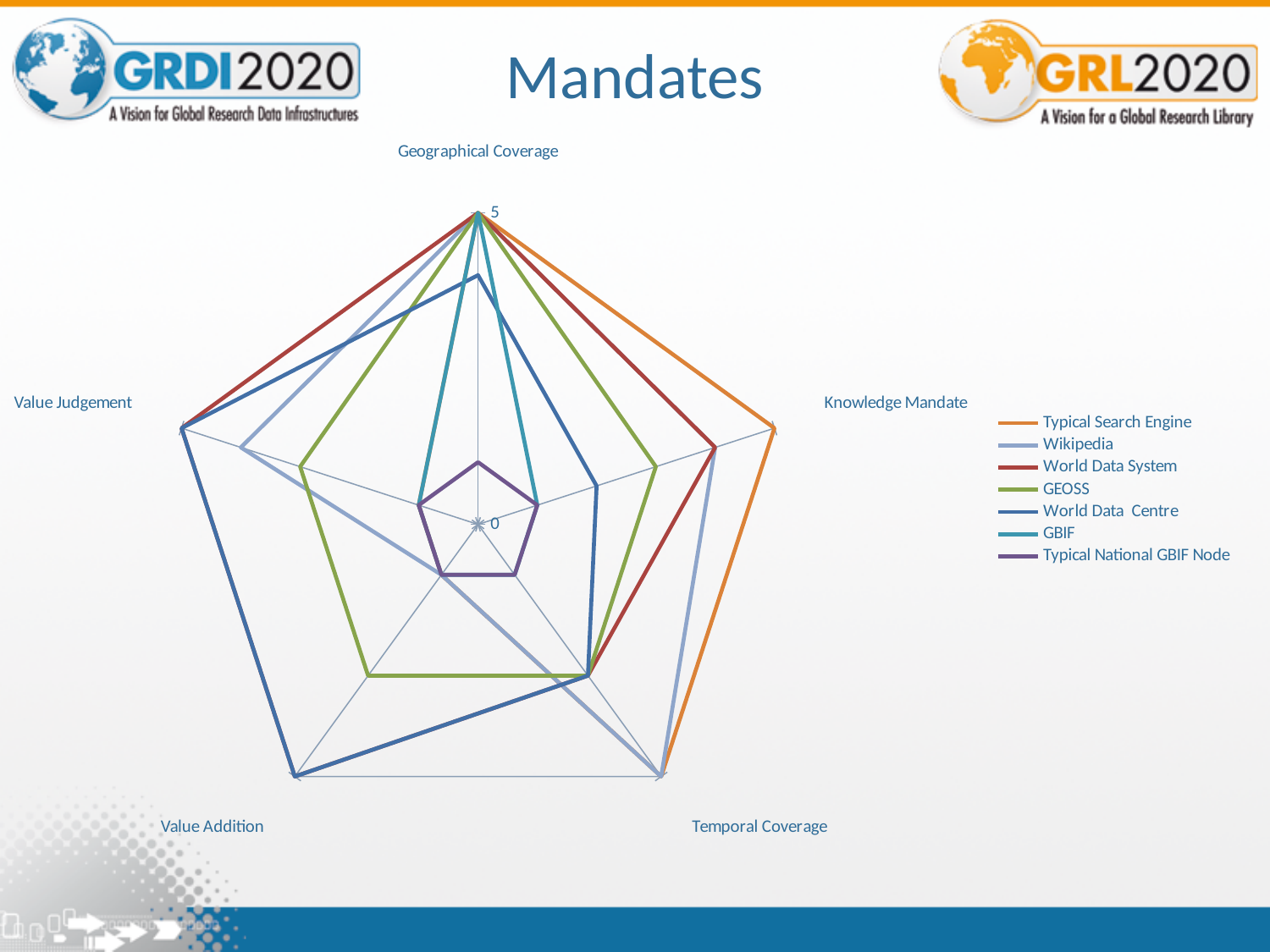
How many series does the legend list? 7 On the Value Judgement axis, which is larger: World Data Centre or Typical National GBIF Node? World Data Centre What kind of chart is shown on the slide? Radar chart Which series has the highest value on the Value Addition axis? World Data System and World Data Centre (tied at 5) What is the value for Typical Search Engine on the Geographical Coverage axis? 5 How many axes (categories) does the radar chart have? 5 What is the value for Wikipedia on the Temporal Coverage axis? 5 What is the title of the chart? Mandates What is the value for Typical Search Engine on the Knowledge Mandate axis? 5 What is the maximum value shown on the radar chart's axis scale? 5 On the Knowledge Mandate axis, which is larger: Typical Search Engine or GBIF? Typical Search Engine What is the value for World Data Centre on the Value Addition axis? 5